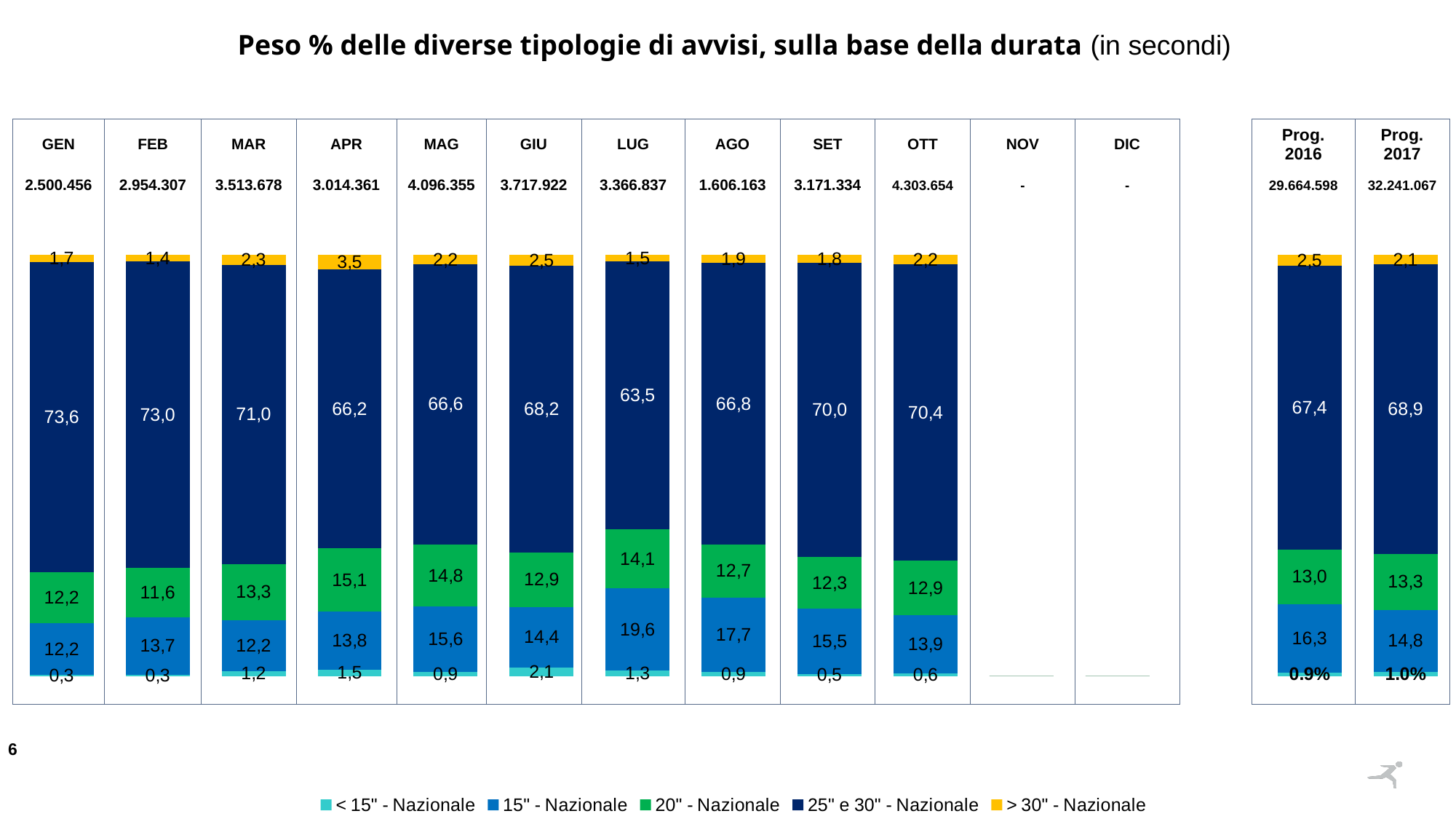
What is the total of the stacked bar for FEB? 100,0 Is the 20" - Nazionale value larger for LUG or for AGO? LUG What is the value of the < 15" - Nazionale segment for Prog. 2017? 1.0% What is the value of the 25" e 30" - Nazionale segment for GEN? 73,6 Which month has the lowest value for the 25" e 30" - Nazionale segment? LUG What kind of chart is shown on the slide? Stacked bar chart What is the value of the 15" - Nazionale segment for LUG? 19,6 What total duration figure is shown above the OTT bar? 4.303.654 What is the value of the > 30" - Nazionale segment for APR? 3,5 What is the difference between the 25" e 30" - Nazionale values for GEN and LUG? 10,1 Which month has the highest value for the 25" e 30" - Nazionale segment? GEN How many series does the legend list? 5